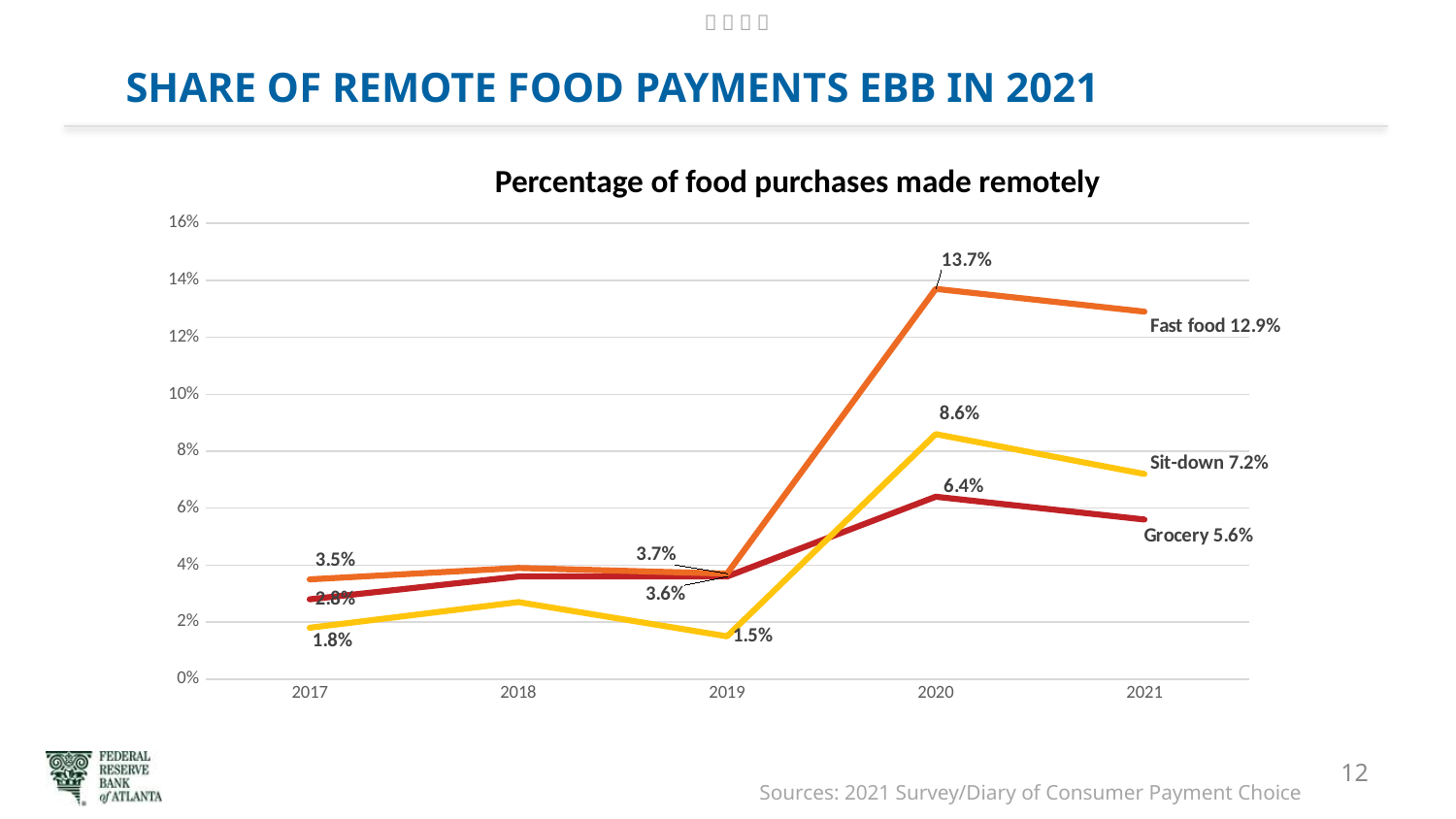
How many years are shown on the x axis? 5 What is the value for Fast food in 2021? 12.9% What type of chart is shown on the slide? line chart What is the value for Grocery in 2021? 5.6% What is the difference between the Fast food values in 2020 and 2021? 0.8% What is the value for Sit-down in 2020? 8.6% Which series has the lowest value in 2019? Sit-down What is the value for Fast food in 2020? 13.7% What is the title of the chart? Percentage of food purchases made remotely How many series are plotted in the chart? 3 Is the value for Sit-down in 2018 greater or less than 4%? less Which series has the highest value in 2020? Fast food